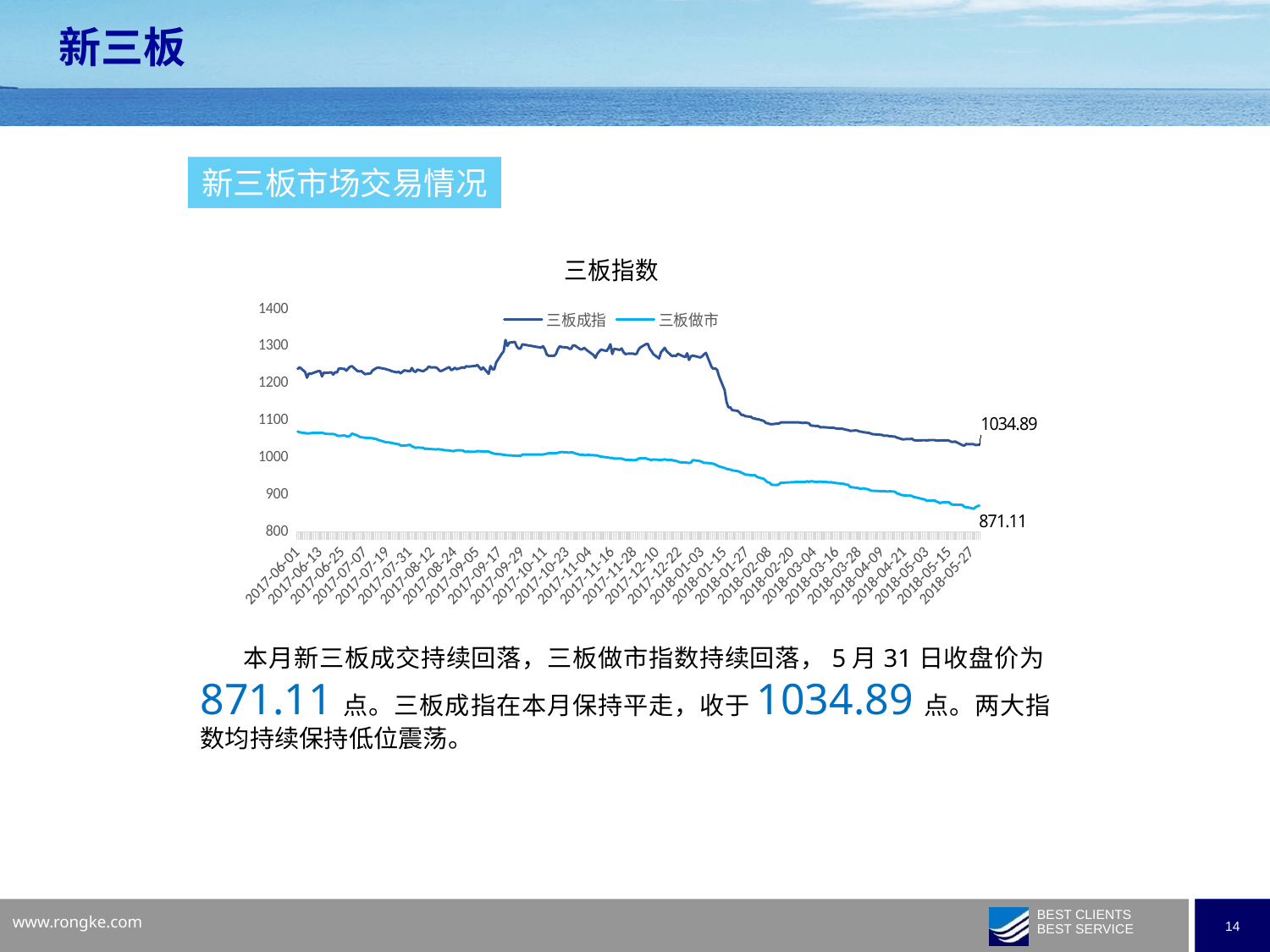
Is the value of 三板做市 at the start of the chart (2017-06-01) greater or less than 1100? less What is the final labelled value of the 三板成指 series? 1034.89 Which series is drawn in the lighter blue colour in the 三板指数 chart? 三板做市 Does the 三板做市 series generally rise or fall from left to right across the chart? fall Is the value of 三板成指 at the start of the chart (2017-06-01) greater or less than 1100? greater Which series ends at a higher value, 三板成指 or 三板做市? 三板成指 What type of chart is shown under the title 三板指数? line chart What is the final labelled value of the 三板做市 series? 871.11 How many series does the legend of the 三板指数 chart list? 2 Is the value of 三板成指 around 2017-10-11 greater or less than 1200? greater What is the title of the chart? 三板指数 What is the difference between the final labelled values of 三板成指 and 三板做市? 163.78